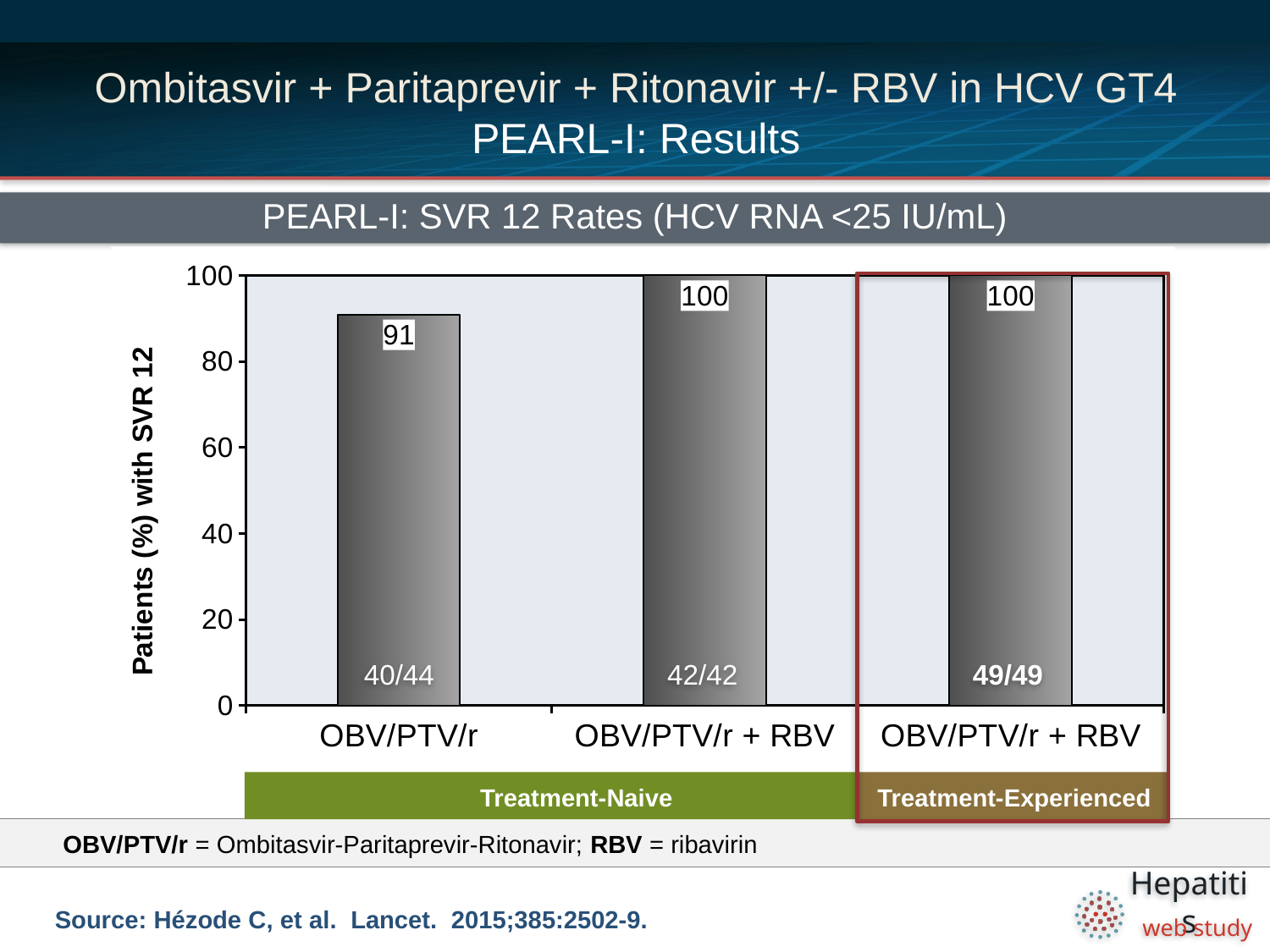
Is the SVR 12 rate for the treatment-naive OBV/PTV/r arm greater or less than 80? greater Which treatment arm has the lowest SVR 12 rate? OBV/PTV/r (Treatment-Naive) How many patients achieved SVR 12 out of the total in the treatment-naive OBV/PTV/r arm? 40/44 What is the title of the chart? PEARL-I: SVR 12 Rates (HCV RNA <25 IU/mL) How many bars are shown in the chart? 3 What is the difference in SVR 12 rate between the treatment-naive OBV/PTV/r + RBV arm and the treatment-naive OBV/PTV/r arm? 9 What is the label of the y-axis? Patients (%) with SVR 12 Which has a higher SVR 12 rate: treatment-naive OBV/PTV/r or treatment-naive OBV/PTV/r + RBV? OBV/PTV/r + RBV How many patients achieved SVR 12 out of the total in the treatment-experienced OBV/PTV/r + RBV arm? 49/49 What is the SVR 12 rate for OBV/PTV/r + RBV in treatment-experienced patients? 100 What is the SVR 12 rate for the OBV/PTV/r arm in treatment-naive patients? 91 What type of chart is shown on the slide? bar chart